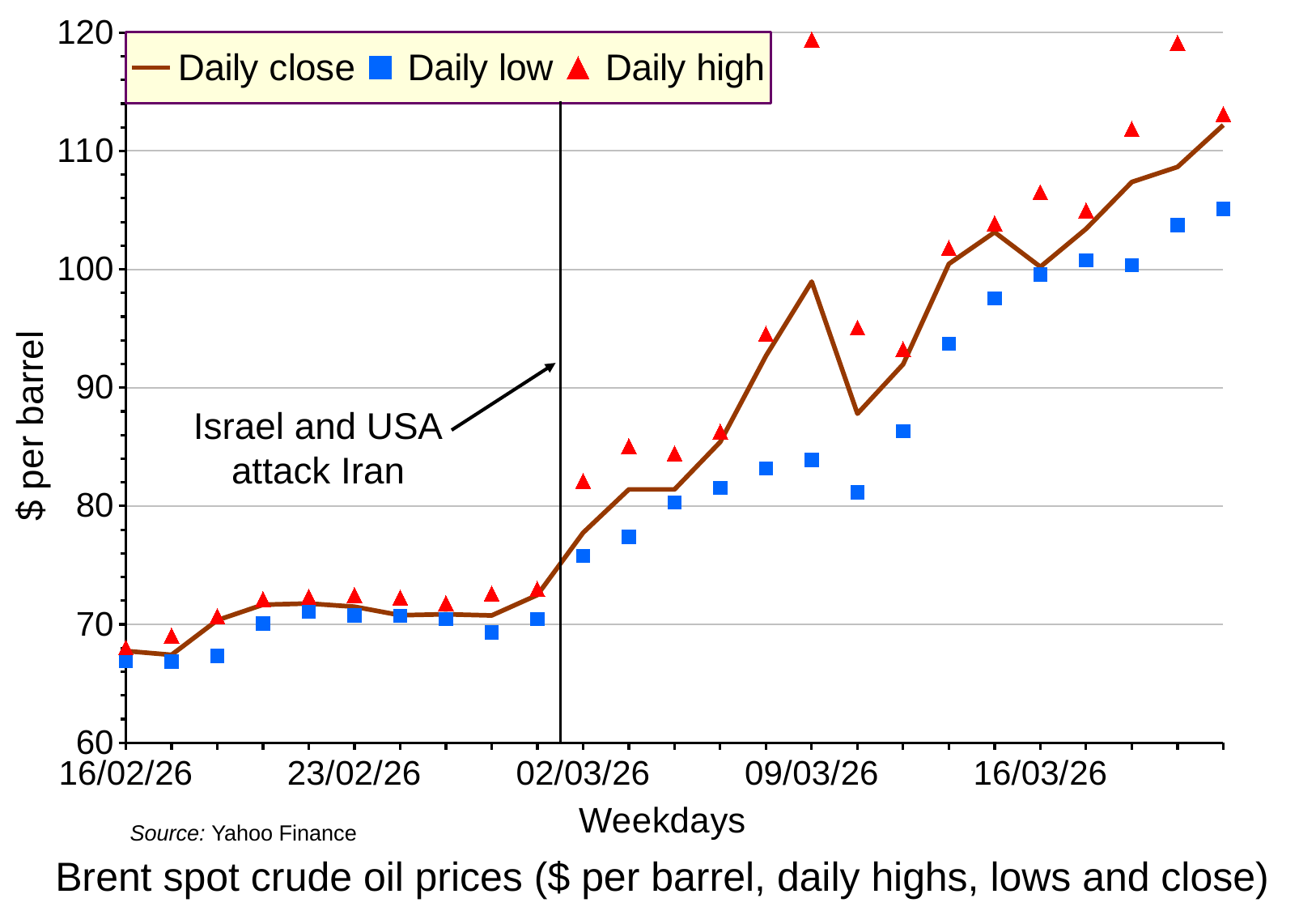
Do Brent crude oil prices rise or fall over the period shown on the x axis? Rise Is the Daily low value on 16/02/26 greater or less than 70? less Is the Daily close value on 02/03/26 greater or less than 80? less What event does the annotation on the chart mark? Israel and USA attack Iran How many weekdays (data points) are plotted for the Daily low series? 25 How many series does the legend list? 3 Is the Daily low value on 09/03/26 greater or less than 90? less Which series are listed in the legend? Daily close, Daily low, Daily high What kind of chart is shown on the slide? Line chart